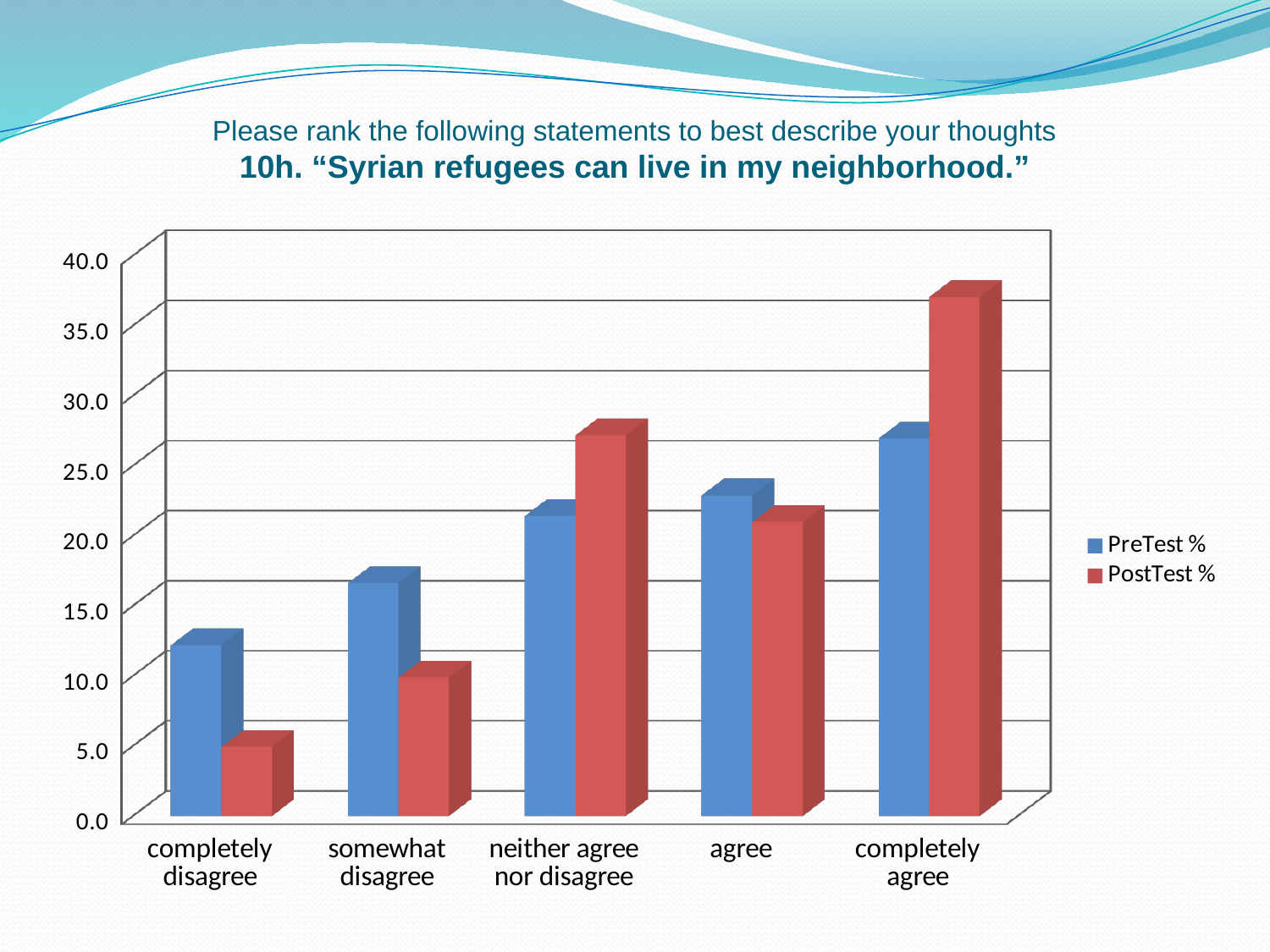
Which category has the lowest PostTest % value? completely disagree For neither agree nor disagree, which is larger: PreTest % or PostTest %? PostTest % Is the PostTest % value for completely agree greater or less than 35.0? greater Is the PostTest % value for completely disagree greater or less than 10.0? less Which category has the highest PreTest % value? completely agree How many series does the legend list? 2 What kind of chart is shown on the slide? bar chart How many response categories are shown on the x axis? 5 For somewhat disagree, which is larger: PreTest % or PostTest %? PreTest % Which category has the lowest PreTest % value? completely disagree What are the two series named in the legend? PreTest % and PostTest % Which category has the highest PostTest % value? completely agree